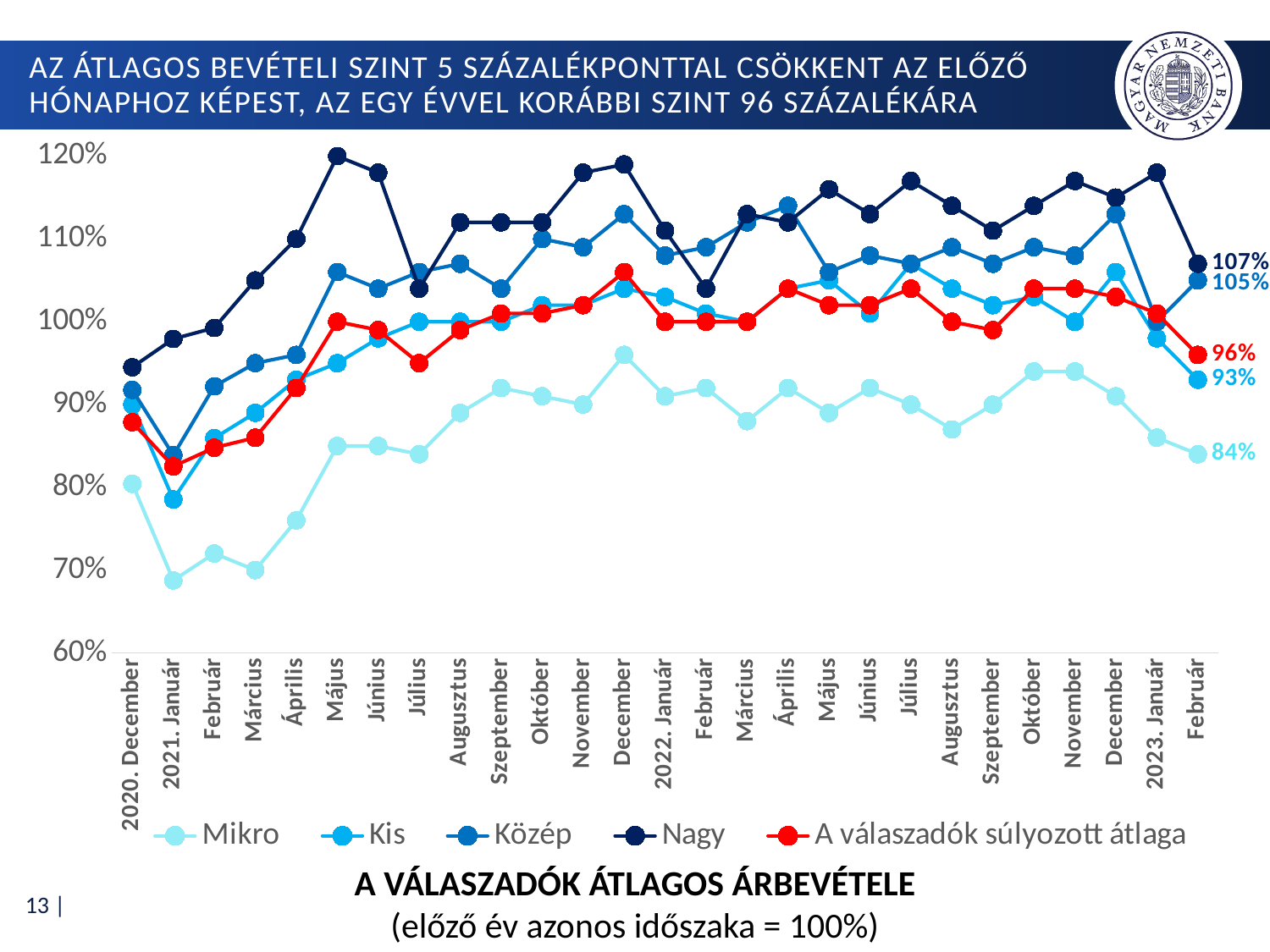
What is the value for 'A válaszadók súlyozott átlaga' in 2023 Február? 96% What is the value for the Mikro series in 2023 Február? 84% What is the value for the Nagy series in 2023 Február? 107% What is the value for the Kis series in 2023 Február? 93% How many series does the legend list? 5 What is the difference between the Nagy and Mikro values in 2023 Február? 23 percentage points Is the value for Mikro in 2021. Január greater or less than 70%? less Which series has the lowest value in 2023 Február? Mikro Which series has the highest value in 2023 Február? Nagy What is the value for the Közép series in 2023 Február? 105% Is the value for Nagy in Május 2021 greater or less than 110%? greater What kind of chart is shown on the slide? Line chart